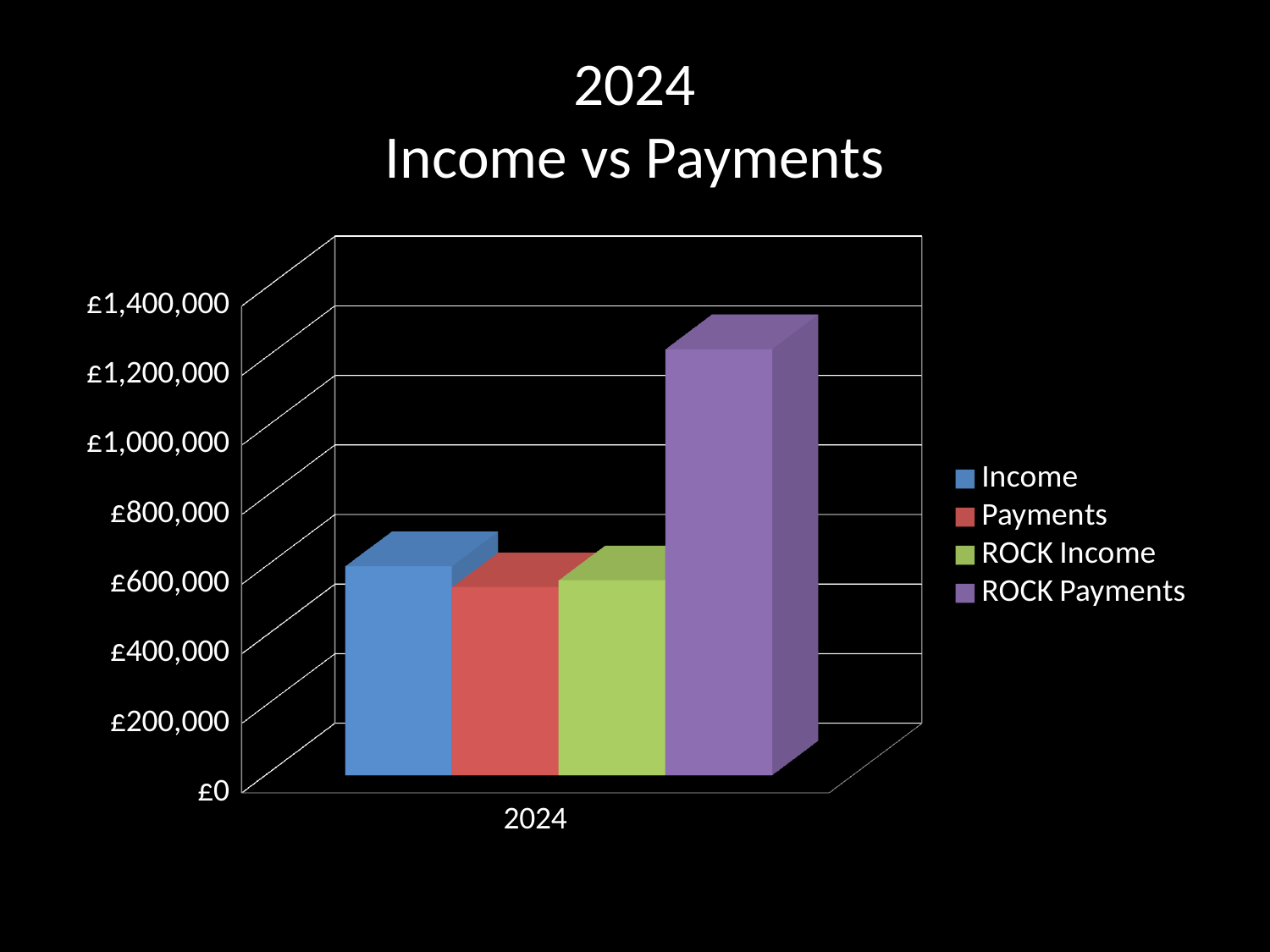
What is the title of the chart? 2024 Income vs Payments Which series is shown in purple in the legend? ROCK Payments Is the value for ROCK Payments greater or less than £1,000,000? greater Is the value for ROCK Income greater or less than £800,000? less How many series does the legend list? 4 Which series has the highest value in 2024? ROCK Payments Is the value for Income greater or less than £800,000? less How many categories are shown on the x axis? 1 Which is larger, ROCK Payments or Income? ROCK Payments What kind of chart is shown on the slide? bar chart